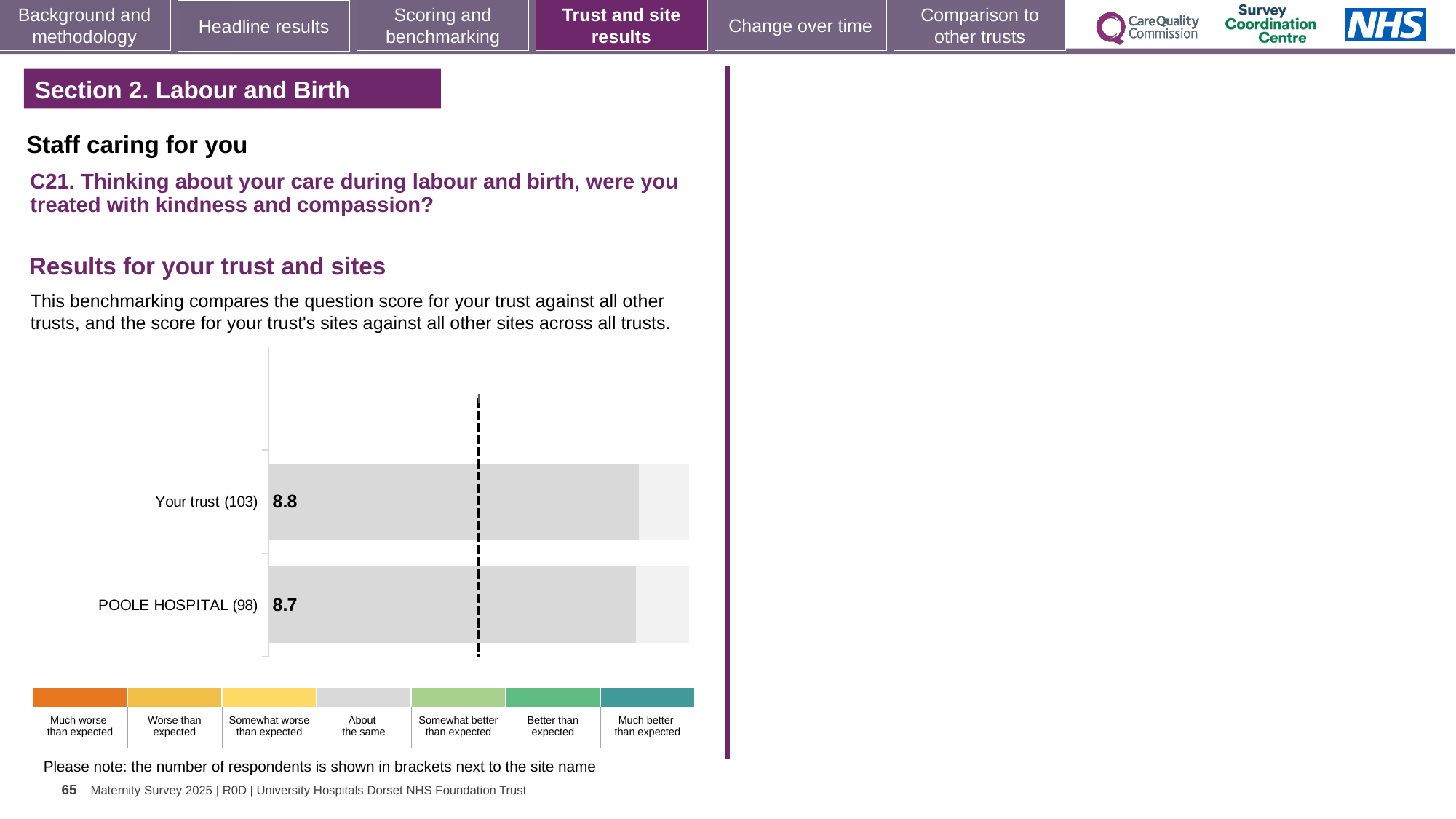
How many respondents are shown in brackets for Your trust? 103 Which bar has the lowest score? POOLE HOSPITAL (98) How many respondents are shown in brackets for POOLE HOSPITAL? 98 Which category of the colour key does the grey colour of the bars correspond to? About the same What is the score for POOLE HOSPITAL (98)? 8.7 What kind of chart is shown on the slide? Bar chart What is the difference between the score for Your trust and the score for POOLE HOSPITAL? 0.1 How many categories does the colour key below the chart list? 7 What is the score for Your trust (103)? 8.8 How many bars are plotted in the chart? 2 Which bar has the higher score, Your trust or POOLE HOSPITAL? Your trust